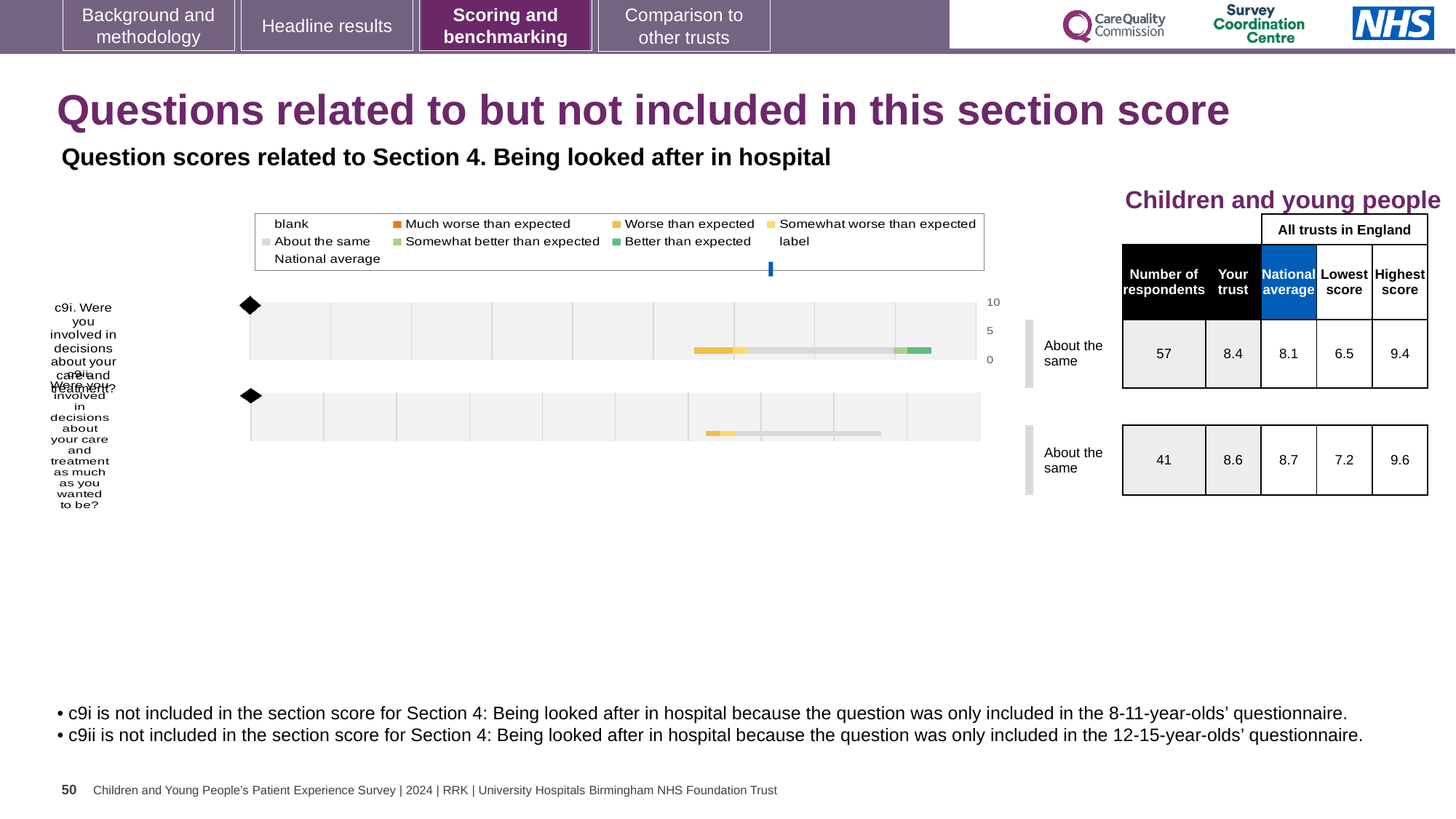
How many entries does the chart legend list? 9 For c9ii, which is larger: the 'Your trust' score or the national average? National average In the table beside the chart, what is the 'Your trust' score for c9i? 8.4 Which question has the higher 'Highest score' across all trusts in England, c9i or c9ii? c9ii What is the difference between the highest score and the lowest score for c9i? 2.9 In the table beside the chart, how many respondents answered c9ii? 41 What benchmark category label is shown next to the c9i chart? About the same For c9i, which is larger: the 'Your trust' score or the national average? Your trust What kind of chart is used to show the c9i and c9ii question scores? bar chart How many questions (c9i, c9ii) are plotted on the slide? 2 What is the highest tick value shown on the chart axis? 10 In the table beside the chart, what is the national average for c9ii? 8.7